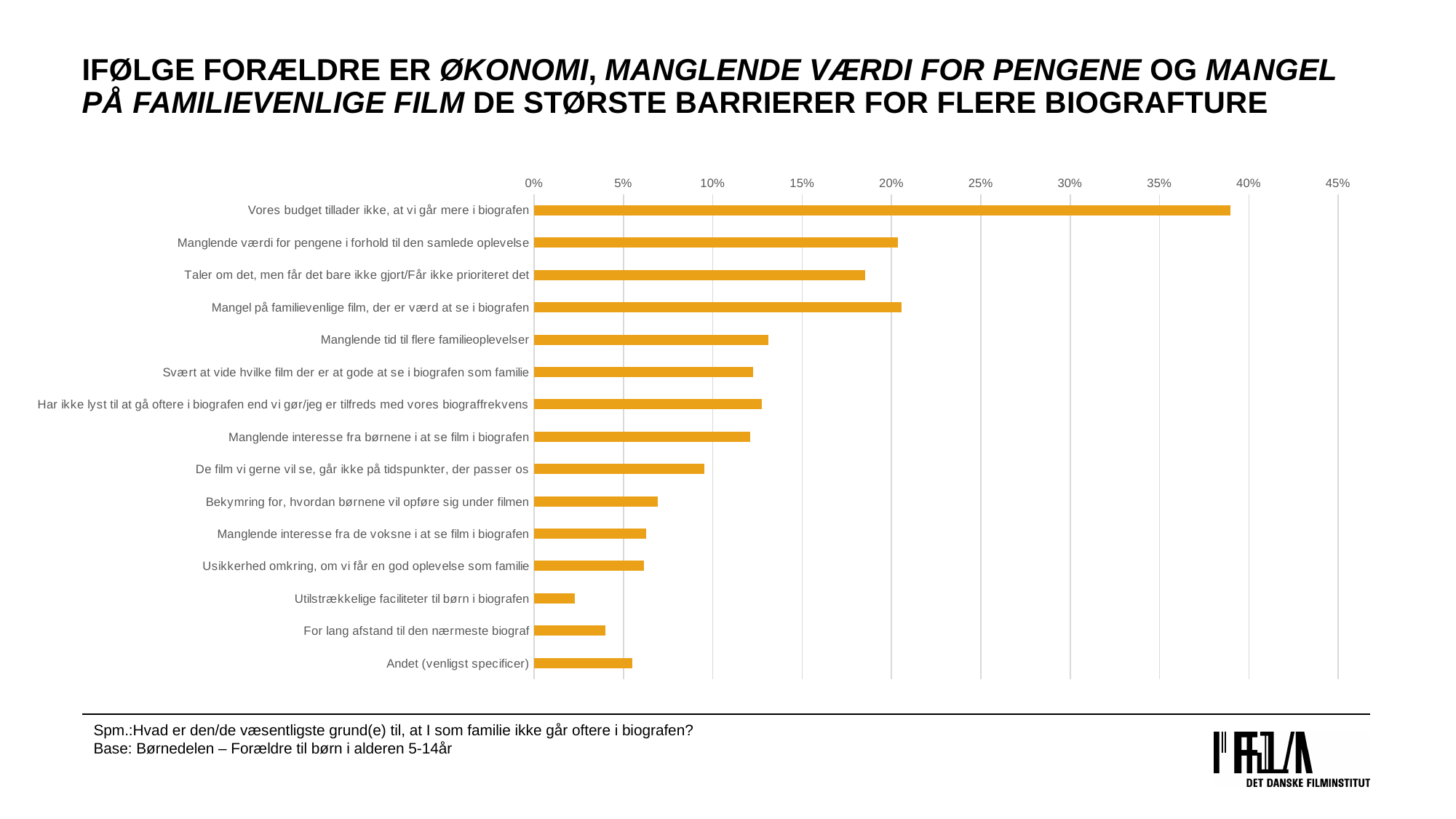
Which category has the lowest value in the chart? Utilstrækkelige faciliteter til børn i biografen Which category has the highest value in the chart? Vores budget tillader ikke, at vi går mere i biografen What is the highest value shown on the percentage axis of the chart? 45% Is the value for 'Mangel på familievenlige film, der er værd at se i biografen' greater or less than 15%? greater Is the value for 'Manglende tid til flere familieoplevelser' greater or less than 10%? greater Is the value for 'Taler om det, men får det bare ikke gjort/Får ikke prioriteret det' greater or less than 20%? less Which is larger: the value for 'Bekymring for, hvordan børnene vil opføre sig under filmen' or for 'Utilstrækkelige faciliteter til børn i biografen'? Bekymring for, hvordan børnene vil opføre sig under filmen Which is larger: the value for 'Vores budget tillader ikke, at vi går mere i biografen' or for 'Manglende værdi for pengene i forhold til den samlede oplevelse'? Vores budget tillader ikke, at vi går mere i biografen What kind of chart is shown on the slide? Bar chart How many categories (reasons) are plotted in the chart? 15